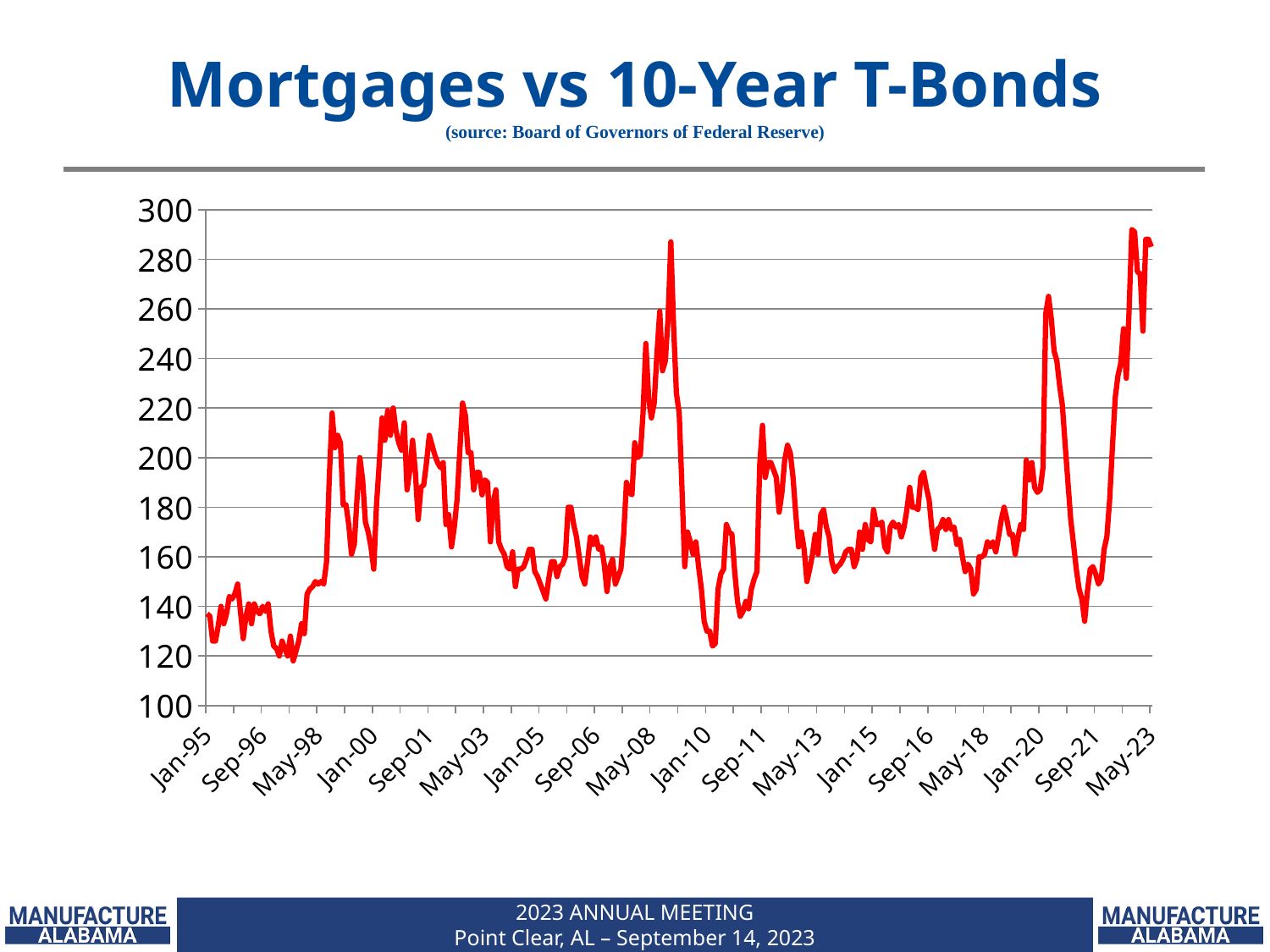
Is the value at May-08 greater or less than 180? greater Is the value at Jan-95 greater or less than 160? less What colour is the plotted line in the chart? red Is the value at May-23 greater or less than 260? greater Does the line rise or fall between Sep-21 and May-23? rise What is the title of the chart on the slide? Mortgages vs 10-Year T-Bonds What kind of chart is shown on the slide? line chart